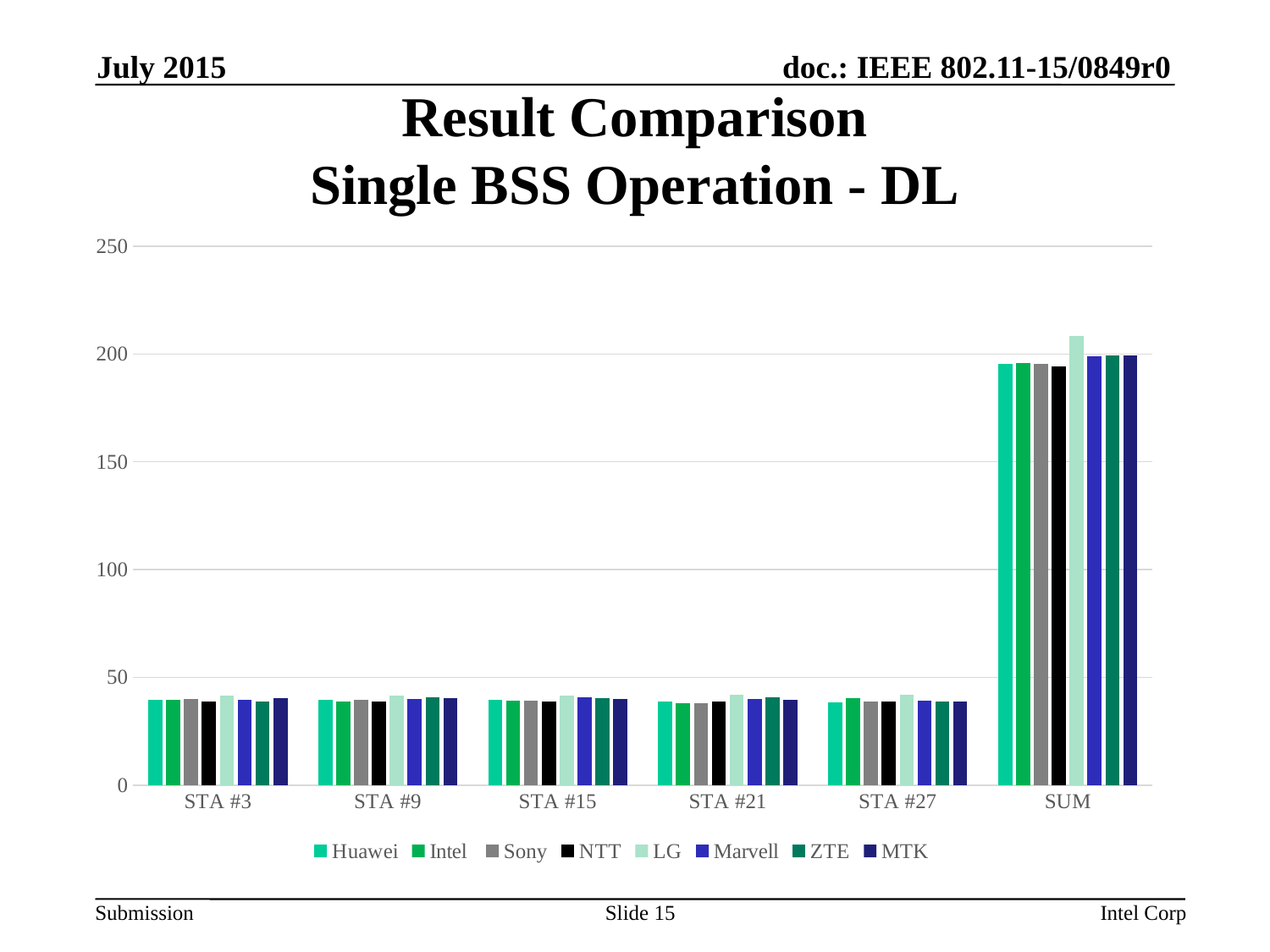
How many categories are shown on the x axis of the chart? 6 How many series does the chart's legend list? 8 What kind of chart is shown on the slide? bar chart Is the value for NTT in the STA #3 category greater or less than 50? less Which series has the highest value in the SUM category? LG What is the title of the chart on the slide? Result Comparison Single BSS Operation - DL Is the value for Huawei in the SUM category greater or less than 150? greater Which is larger: the value for Intel in the SUM category or the value for Intel in the STA #9 category? SUM Is the value for LG in the SUM category greater or less than 200? greater Which series is shown in black in the chart's legend? NTT In the SUM category, which is larger: the value for LG or the value for NTT? LG